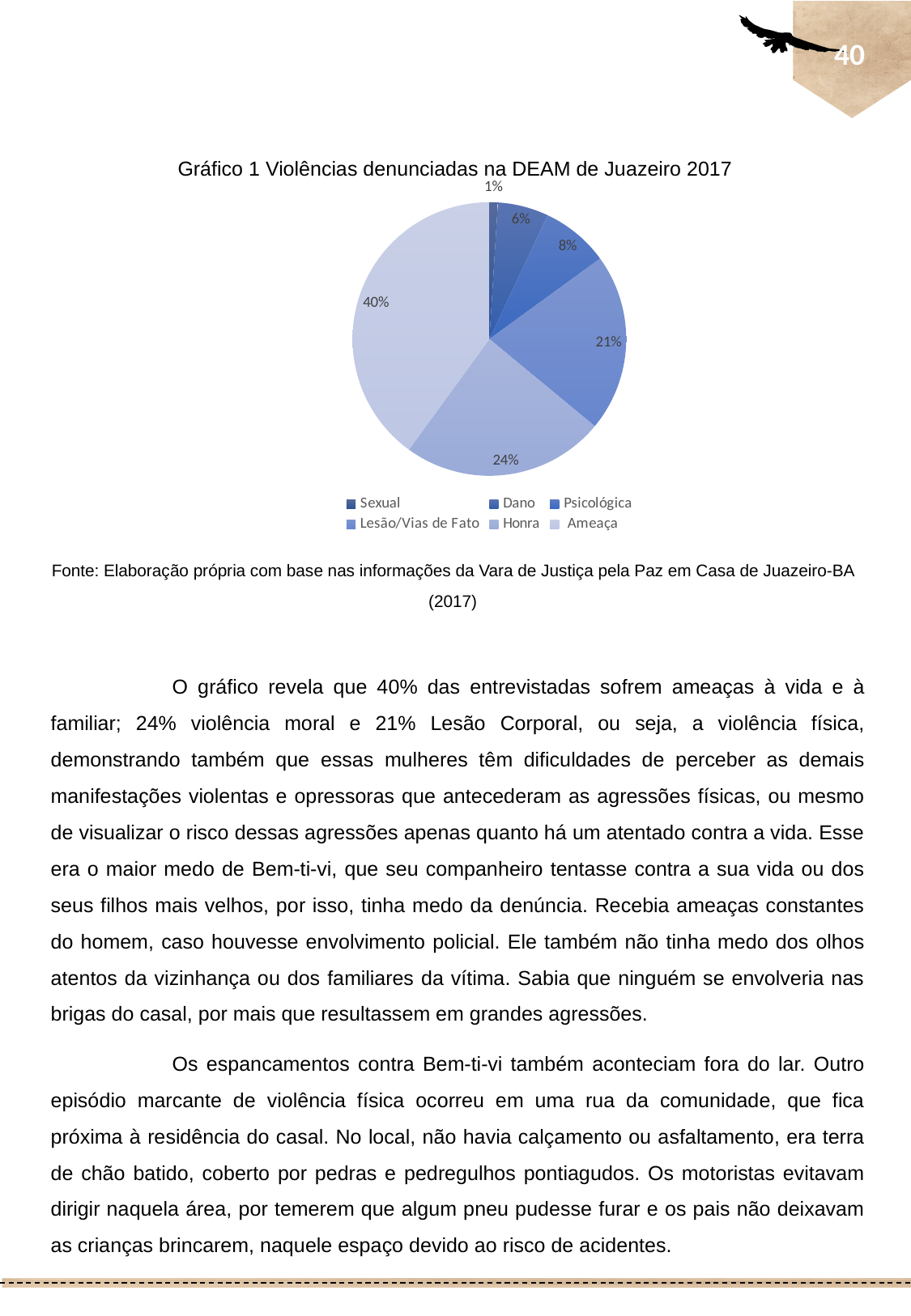
What share of the pie does Ameaça represent? 40% What is the title of the chart? Gráfico 1 Violências denunciadas na DEAM de Juazeiro 2017 What share of the pie does Psicológica represent? 8% What share of the pie does Lesão/Vias de Fato represent? 21% What is the difference in percentage points between the Ameaça slice and the Honra slice? 16 Which slice is larger, Lesão/Vias de Fato or Psicológica? Lesão/Vias de Fato What kind of chart is shown on the slide? pie chart How many categories does the legend of the pie chart list? 6 Which category has the smallest slice of the pie? Sexual Which category has the largest slice of the pie? Ameaça